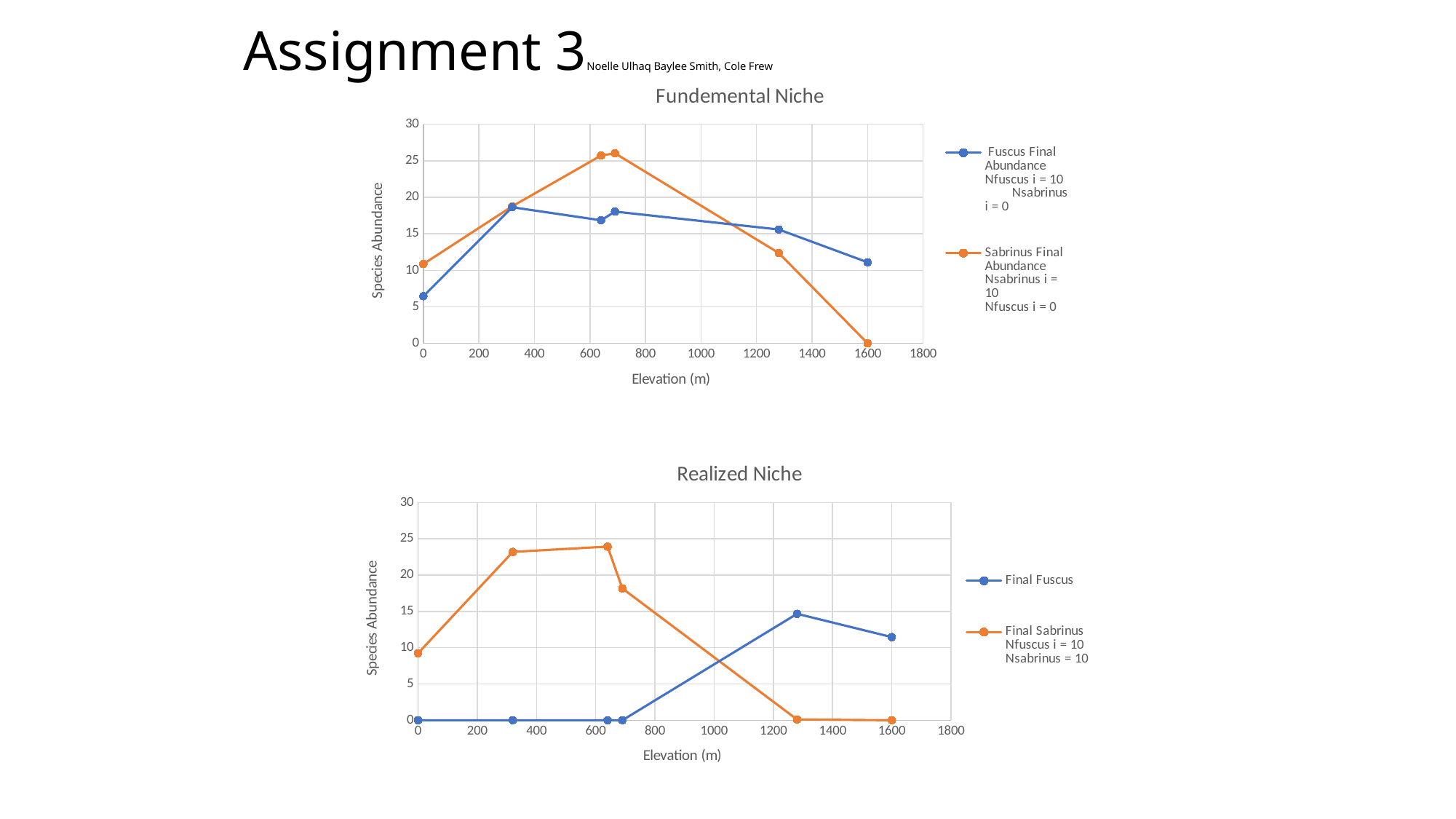
In the Fundemental Niche chart, what is the Sabrinus Final Abundance at 1600 m elevation? 0 In the Fundemental Niche chart, which series reaches the highest species abundance? Sabrinus Final Abundance How many series does the legend of the Fundemental Niche chart list? 2 In the Realized Niche chart, what is the Final Sabrinus abundance at 1600 m elevation? 0 In the Realized Niche chart, how many data points does the Final Fuscus series have? 6 In the Fundemental Niche chart, is the Fuscus Final Abundance at 0 m greater or less than 10? less What type of chart is the Fundemental Niche chart? line chart In the Realized Niche chart, is the highest Final Sabrinus value greater or less than 20? greater In the Realized Niche chart, what is the Final Fuscus abundance at 0 m elevation? 0 How many series does the legend of the Realized Niche chart list? 2 In the Fundemental Niche chart, is the Fuscus Final Abundance at 1600 m greater or less than 15? less In the Realized Niche chart, at 1600 m elevation, which series has the larger value, Final Fuscus or Final Sabrinus? Final Fuscus